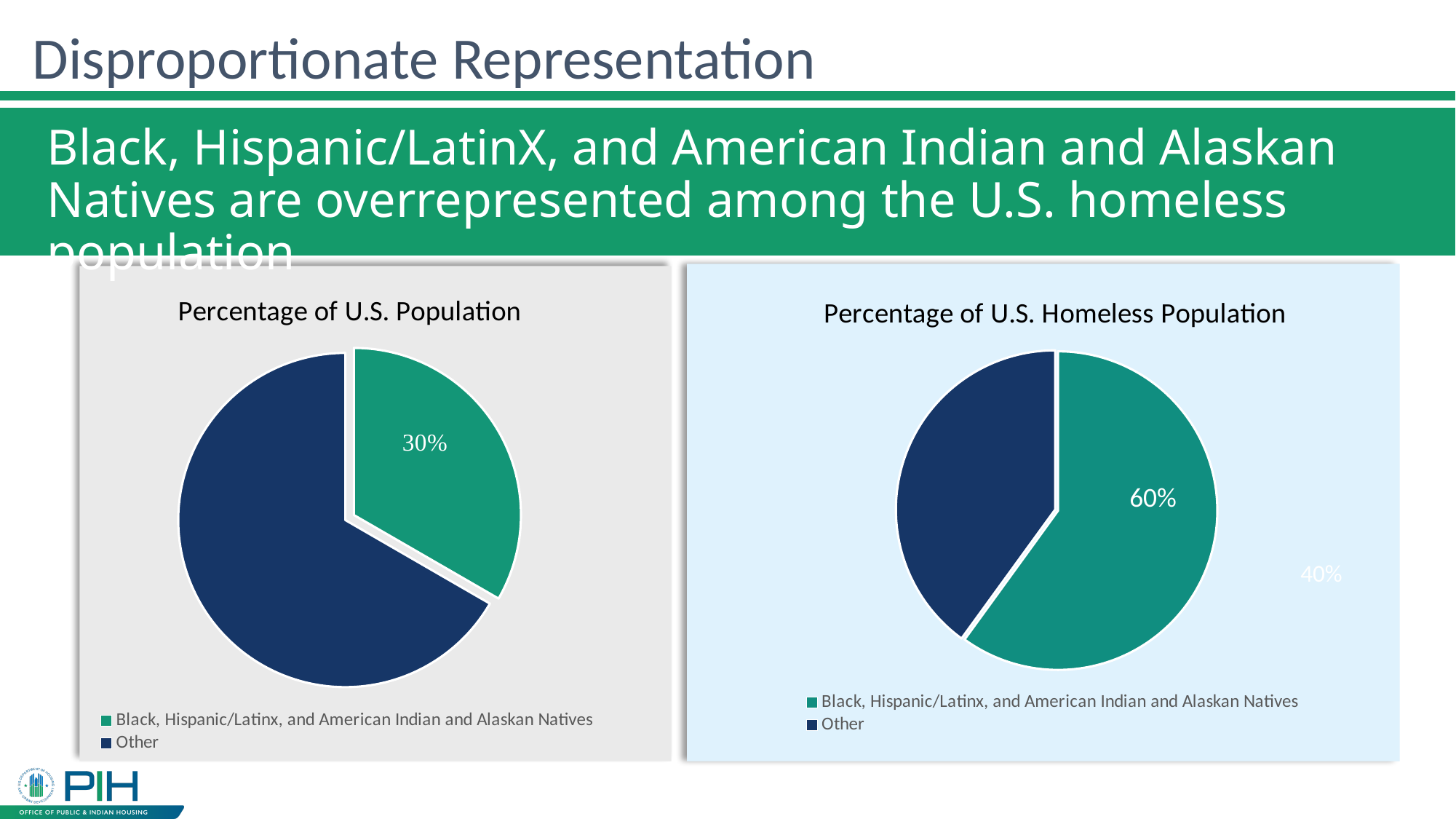
What kind of chart is the 'Percentage of U.S. Population' chart? Pie chart How much higher is the Black, Hispanic/Latinx, and American Indian and Alaskan Natives share in the 'Percentage of U.S. Homeless Population' chart than in the 'Percentage of U.S. Population' chart? 30 percentage points How many entries does the legend of the 'Percentage of U.S. Population' chart list? 2 In the 'Percentage of U.S. Population' chart, what percentage is shown for Black, Hispanic/Latinx, and American Indian and Alaskan Natives? 30% What colour represents the 'Other' category in both pie charts? Dark blue In the 'Percentage of U.S. Homeless Population' chart, what percentage is shown for Other? 40% How many slices does the 'Percentage of U.S. Homeless Population' pie chart have? 2 In the 'Percentage of U.S. Homeless Population' chart, which category has the largest slice? Black, Hispanic/Latinx, and American Indian and Alaskan Natives In the 'Percentage of U.S. Population' chart, which slice is larger: Black, Hispanic/Latinx, and American Indian and Alaskan Natives, or Other? Other In the 'Percentage of U.S. Homeless Population' chart, what percentage is shown for Black, Hispanic/Latinx, and American Indian and Alaskan Natives? 60% In the 'Percentage of U.S. Homeless Population' chart, which category has the smallest slice? Other In the 'Percentage of U.S. Homeless Population' chart, what is the difference between the Black, Hispanic/Latinx, and American Indian and Alaskan Natives slice and the Other slice? 20 percentage points